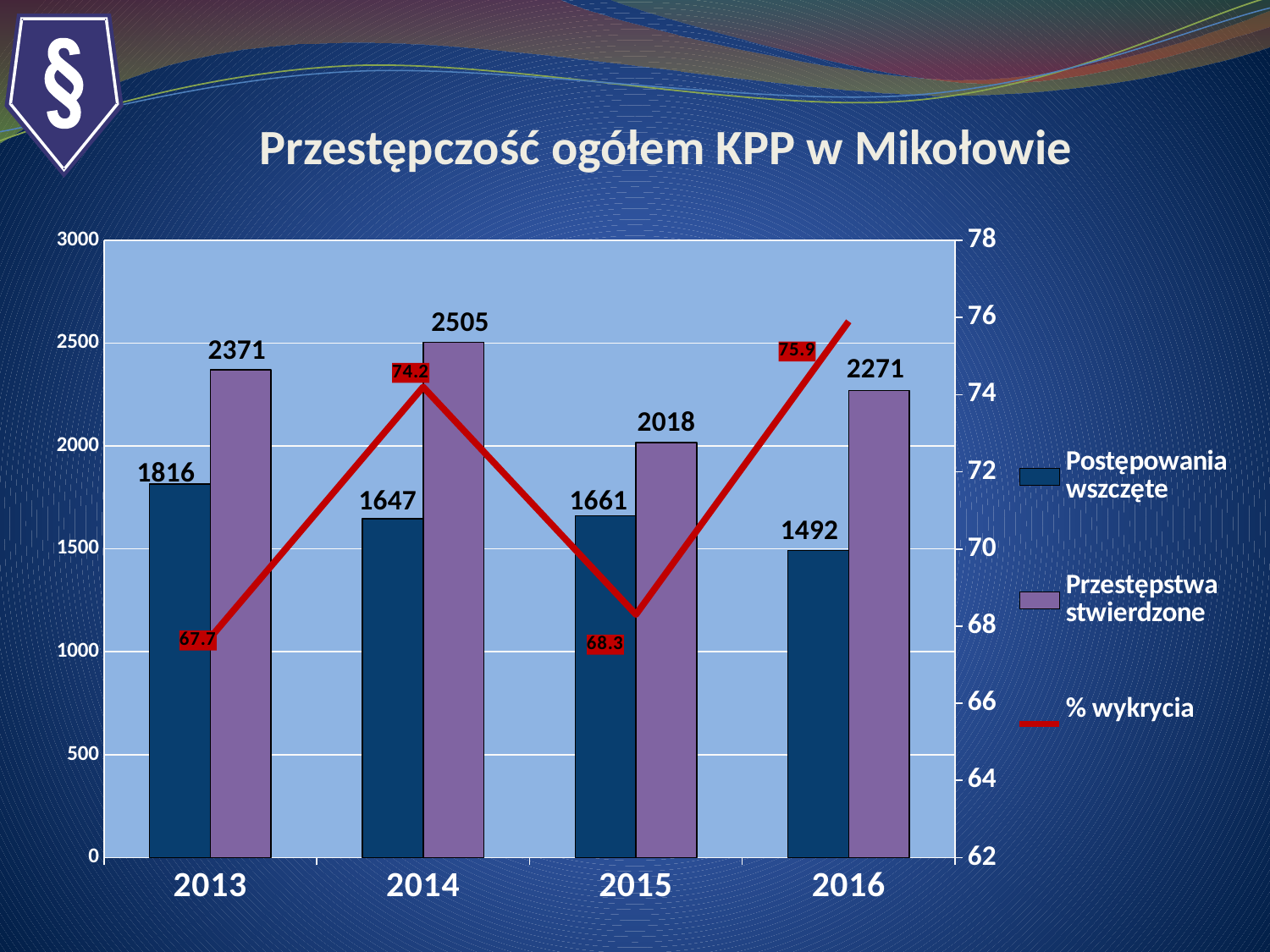
What is the % wykrycia value for 2016? 75.9 What kind of chart is this? Combined bar and line chart Which is larger: Przestępstwa stwierdzone in 2013 or in 2016? 2013 What is the difference between Przestępstwa stwierdzone and Postępowania wszczęte in 2015? 357 How many years are shown on the x axis? 4 What is the value of Przestępstwa stwierdzone in 2014? 2505 What is the value of Postępowania wszczęte in 2013? 1816 In which year is Przestępstwa stwierdzone highest? 2014 What is the title of the chart? Przestępczość ogółem KPP w Mikołowie Does Postępowania wszczęte rise or fall from 2015 to 2016? Fall How many series does the legend list? 3 In which year is Postępowania wszczęte lowest? 2016